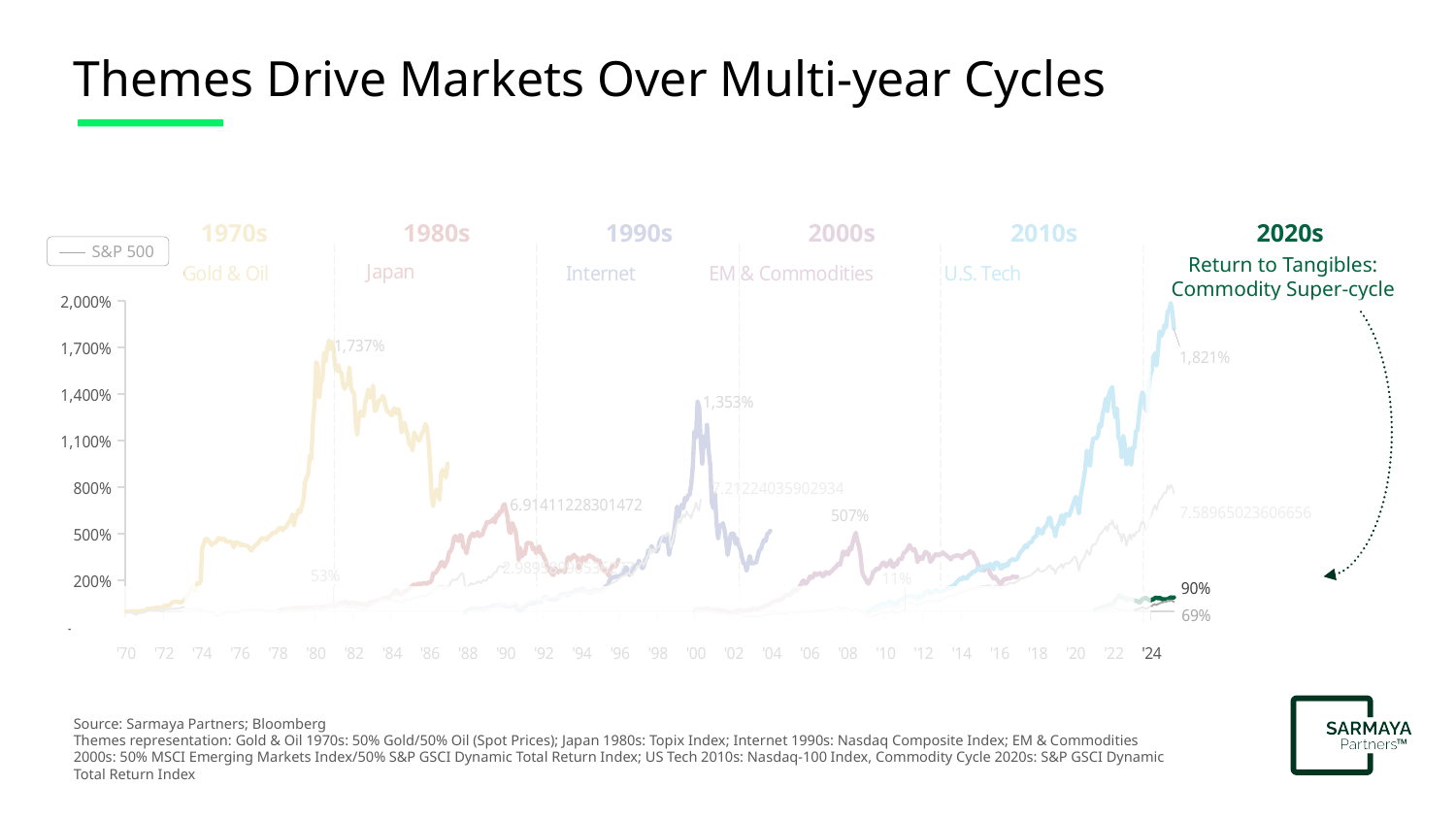
What is the labeled peak value of the 1990s Internet theme line? 1,353% Which labeled peak is larger: the 1970s Gold & Oil peak or the 2010s U.S. Tech peak? 2010s U.S. Tech How many decade themes are labeled across the top of the chart? 6 What is the labeled peak value of the 2010s U.S. Tech theme line? 1,821% What is the difference between the 2010s U.S. Tech peak (1,821%) and the 1970s Gold & Oil peak (1,737%)? 84% Is the peak of the 1980s Japan theme line greater or less than 500%? greater Which decade theme has the highest labeled peak value? 2010s U.S. Tech What value is labeled for the 2020s Commodity Super-cycle line at the right end of the chart? 90% What is the labeled peak value of the 2000s EM & Commodities theme line? 507% What kind of chart is shown on the slide? line chart What is the labeled peak value of the 1970s Gold & Oil theme line? 1,737% What value is labeled for the S&P 500 line at the right end of the chart? 69%